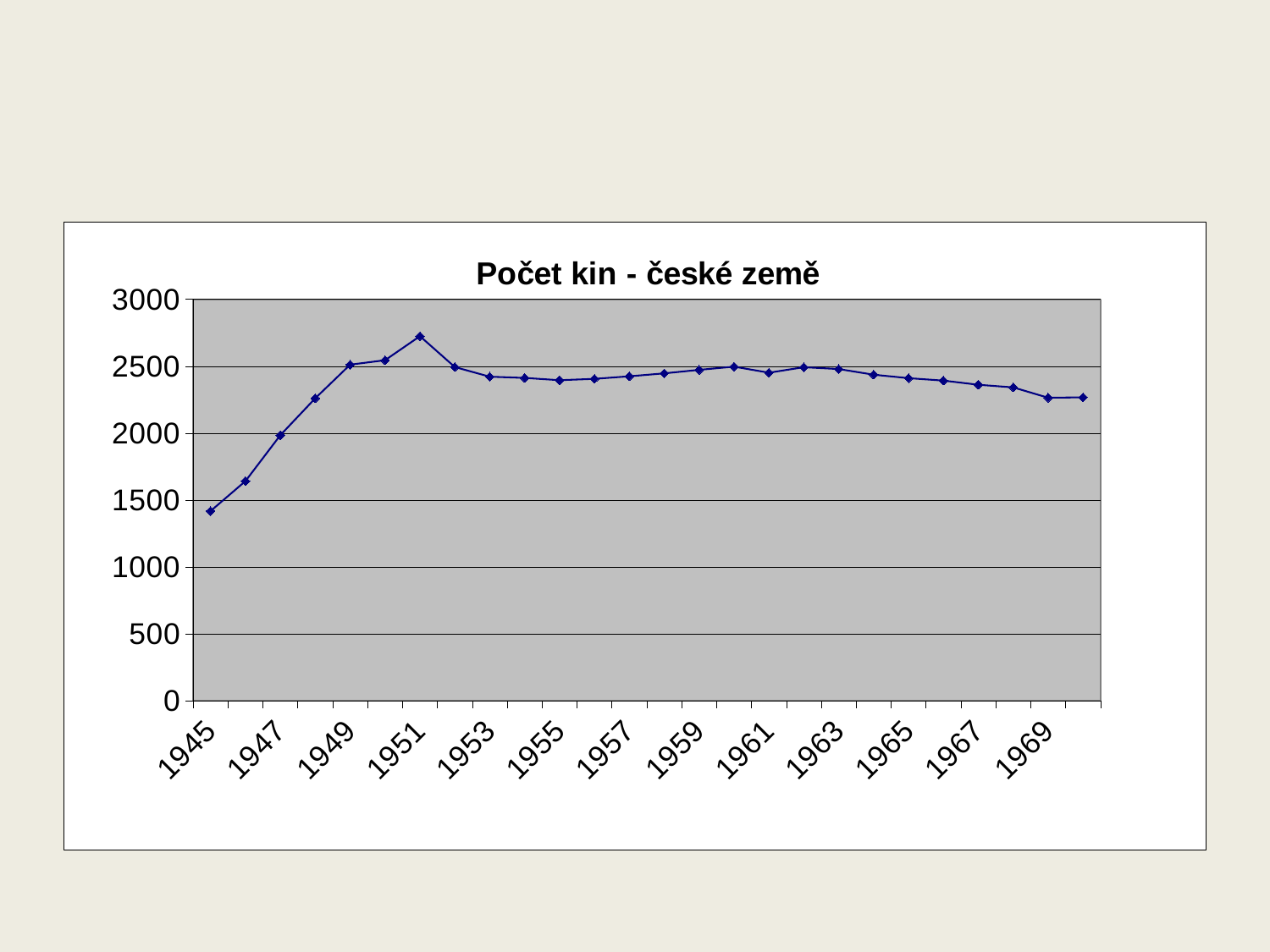
Is the value for 1951 greater or less than 2500? greater Do the values rise or fall between 1945 and 1951? rise Is the value for 1969 greater or less than 2000? greater Which year has the larger value, 1951 or 1953? 1951 In which year does the line reach its highest value? 1951 What is the title of the chart? Počet kin - české země What kind of chart is shown on the slide? line chart Which year has the larger value, 1945 or 1969? 1969 In which year does the line have its lowest value? 1945 Is the value for 1945 greater or less than 1500? less Do the values rise or fall between 1963 and 1969? fall